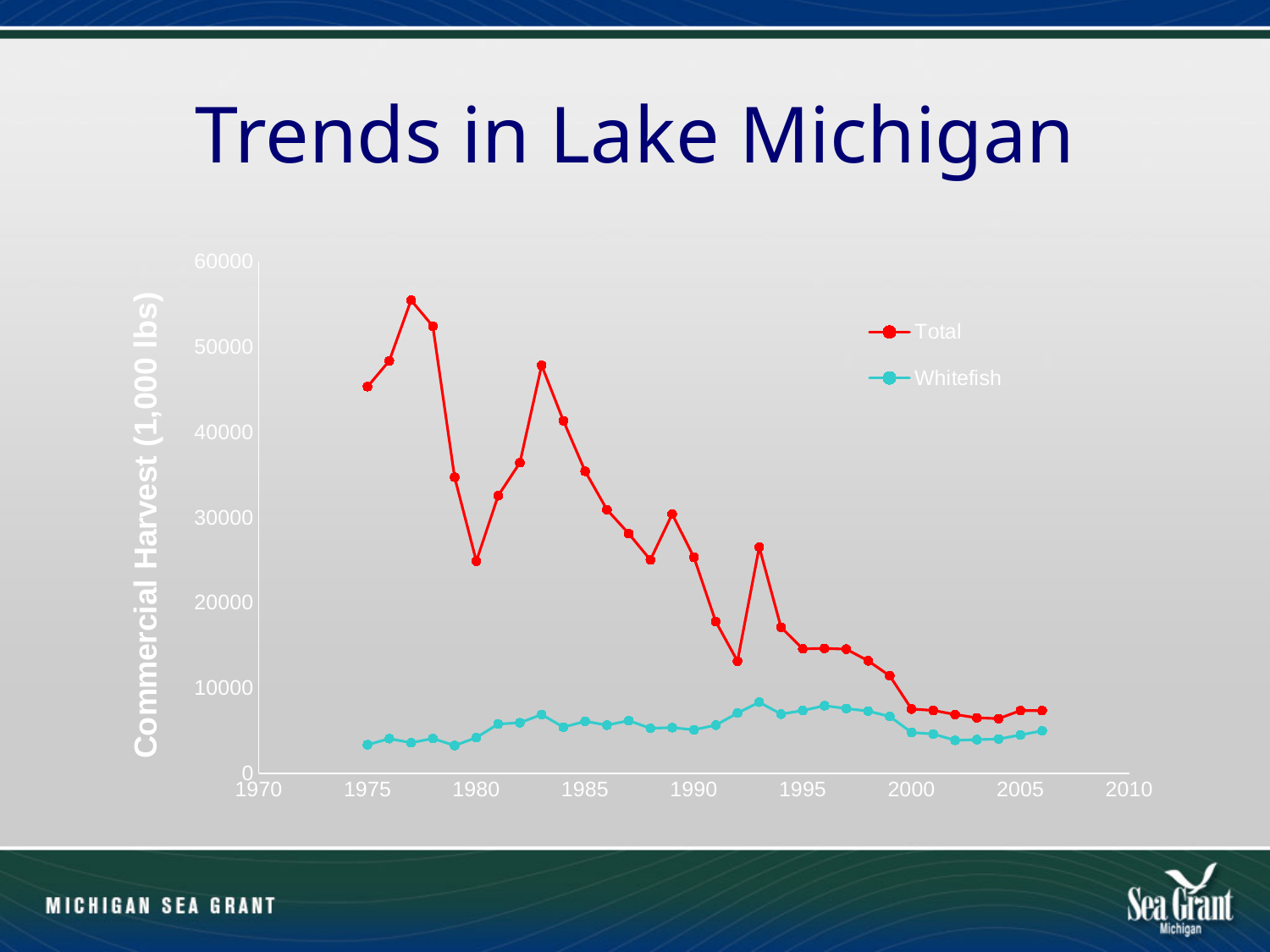
Is the Total value for 1980 greater or less than 30000? less Is the Total value for 2006 greater or less than 10000? less Overall, does the Total series rise or fall from 1975 to 2006? fall Is the Whitefish value for 1993 greater or less than 10000? less How many series does the legend list? 2 In which year does the Total series reach its highest value? 1977 What is the label on the vertical axis? Commercial Harvest (1,000 lbs) Which is larger, the Total value in 1989 or the Total value in 1992? 1989 What kind of chart is shown on the slide? line chart What are the two series named in the legend? Total and Whitefish